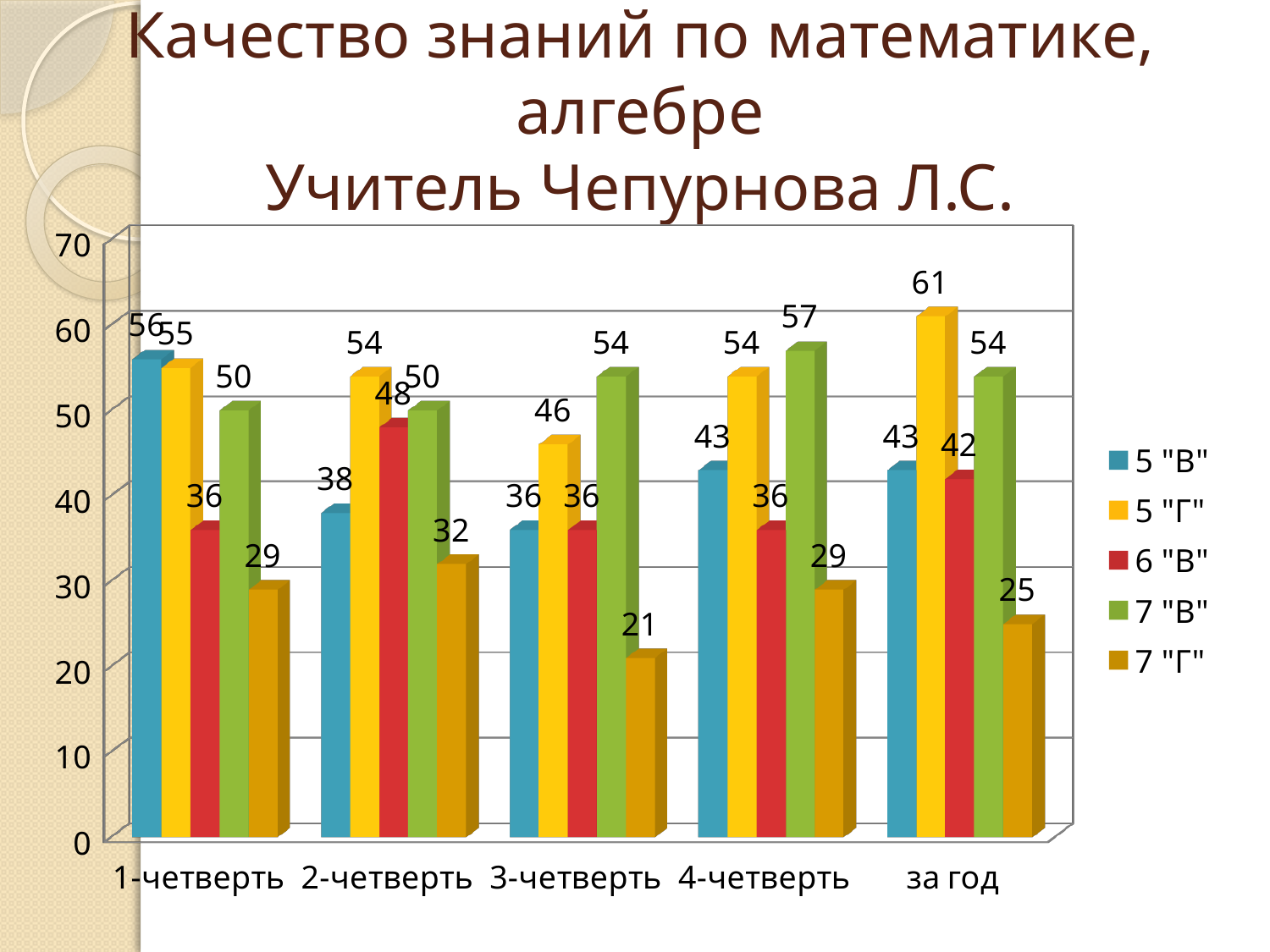
Which series has the lowest value in 1-четверть? 7 "Г" Which is larger in 2-четверть: the value for 5 "В" or the value for 6 "В"? 6 "В" Which series is shown in red in the legend? 6 "В" What kind of chart is shown on the slide? bar chart How many categories are shown on the x axis? 5 Does the value for 5 "В" rise or fall from 1-четверть to 3-четверть? fall What is the value for 5 "Г" in за год? 61 What is the value for 7 "Г" in 3-четверть? 21 What is the value for 6 "В" in 2-четверть? 48 What is the difference between the 5 "Г" and 7 "Г" values in за год? 36 How many series does the legend list? 5 Which series has the highest value in 4-четверть? 7 "В"